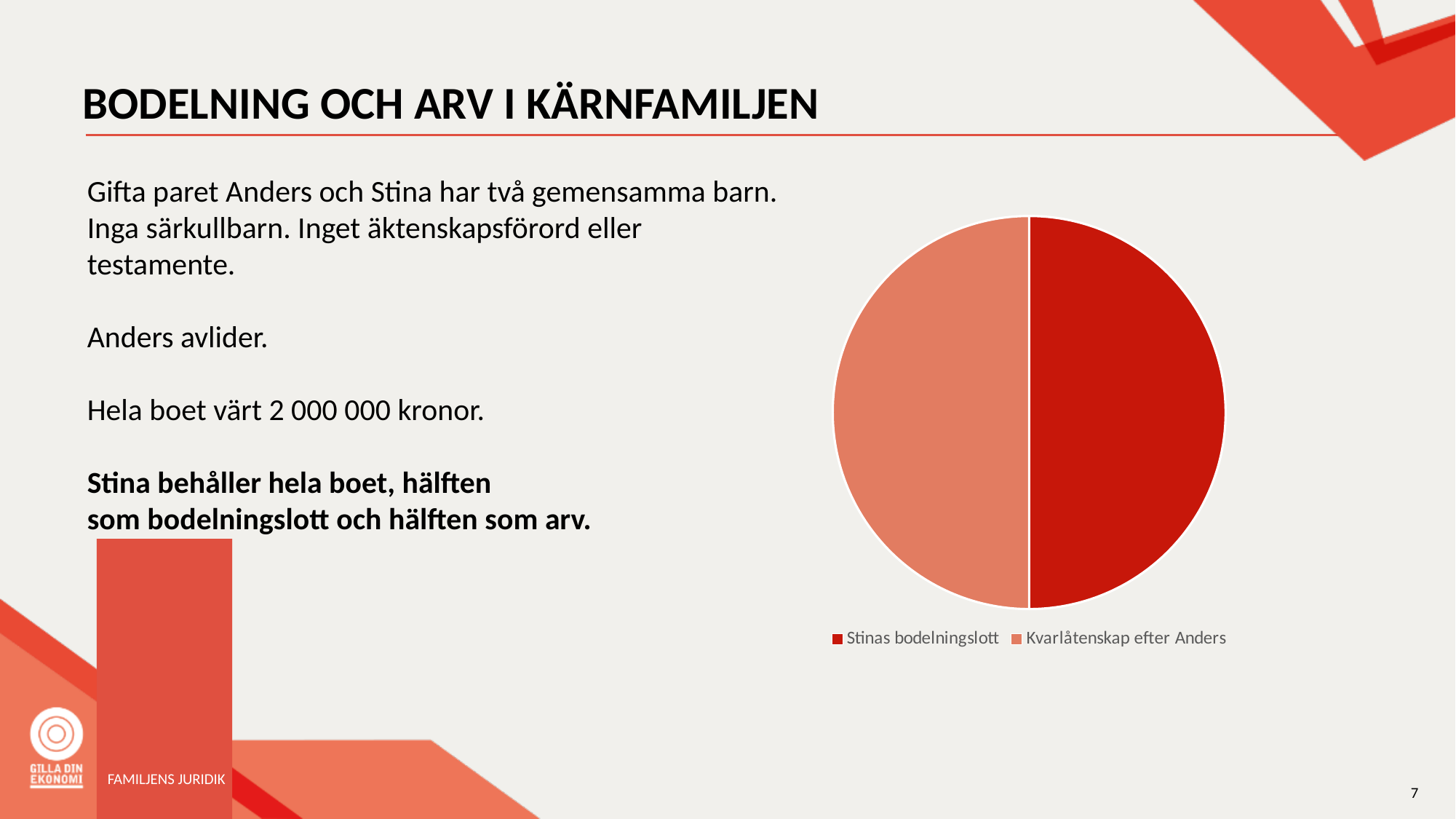
What are the two legend entries of the pie chart? Stinas bodelningslott and Kvarlåtenskap efter Anders How many entries does the legend of the pie chart list? 2 Are the two slices of the pie chart equal in size? yes Which legend entry is shown in the darker red colour in the pie chart? Stinas bodelningslott How many slices does the pie chart have? 2 What kind of chart is shown on the slide? pie chart